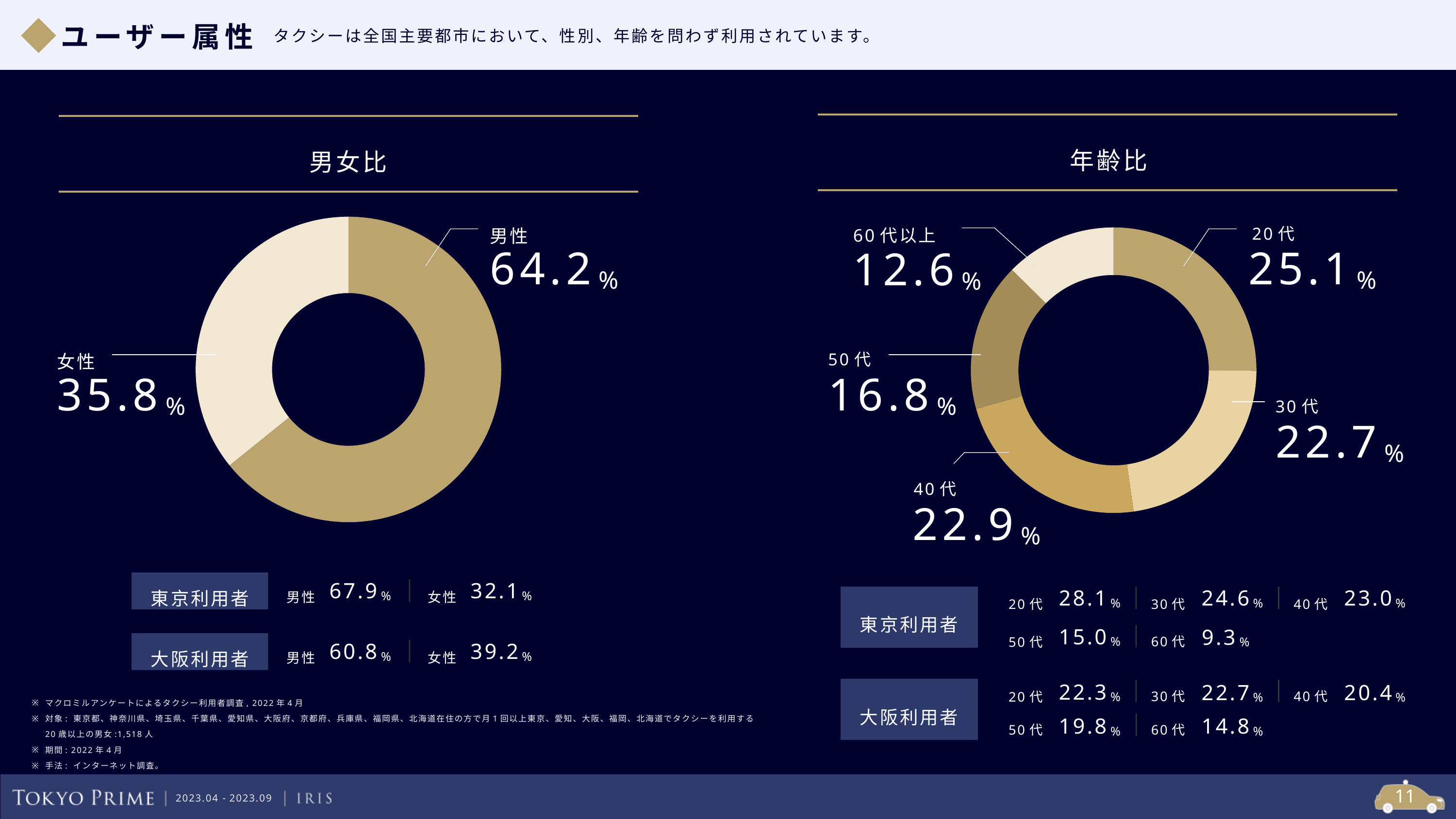
What kind of chart is the 男女比 chart? Donut (pie) chart In the 男女比 chart, what is the difference between the 男性 and 女性 shares? 28.4% In the 年齢比 chart, which is larger, the share for 30代 or the share for 50代? 30代 In the 年齢比 chart, what is the value for 60代以上? 12.6% In the 年齢比 chart, what is the value for 50代? 16.8% In the 男女比 chart, what is the value for 女性? 35.8% In the 年齢比 chart, what is the difference between the 20代 and 60代以上 shares? 12.5% In the 年齢比 chart, what is the value for 20代? 25.1% In the 年齢比 chart, how many age categories are shown? 5 In the 年齢比 chart, which age group has the largest share? 20代 In the 男女比 chart, what is the value for 男性? 64.2% In the 年齢比 chart, which age group has the smallest share? 60代以上